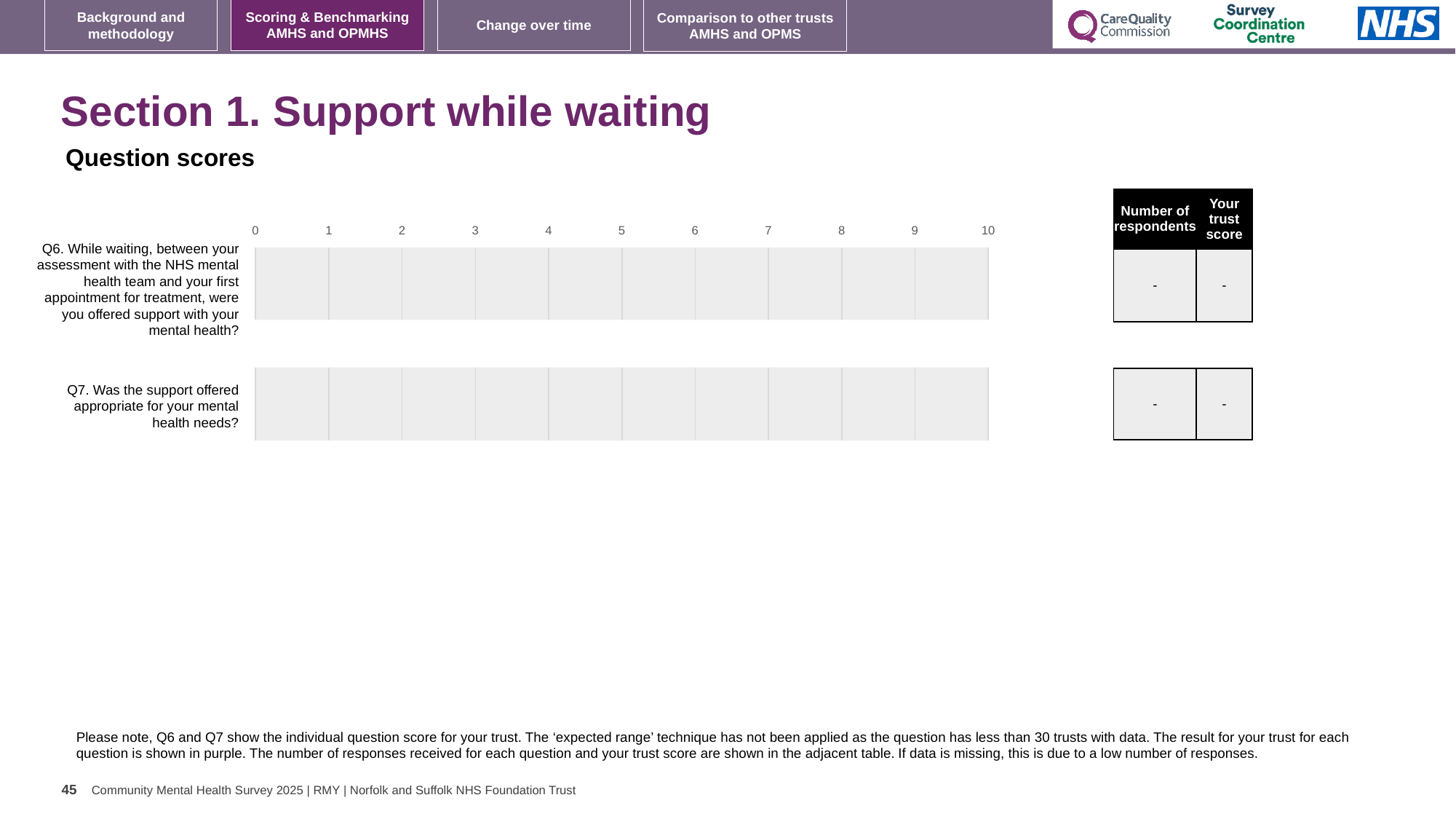
What is the highest value shown on the chart's horizontal axis? 10 What kind of chart is used for the question scores? bar chart What heading appears directly above the chart? Question scores What is the 'Number of respondents' value shown in the table for Q7? - How many questions are listed as categories on the chart? 2 What is the 'Your trust score' value shown in the table for Q6? - What is the 'Your trust score' value shown in the table for Q7? - What is the 'Number of respondents' value shown in the table for Q6? -